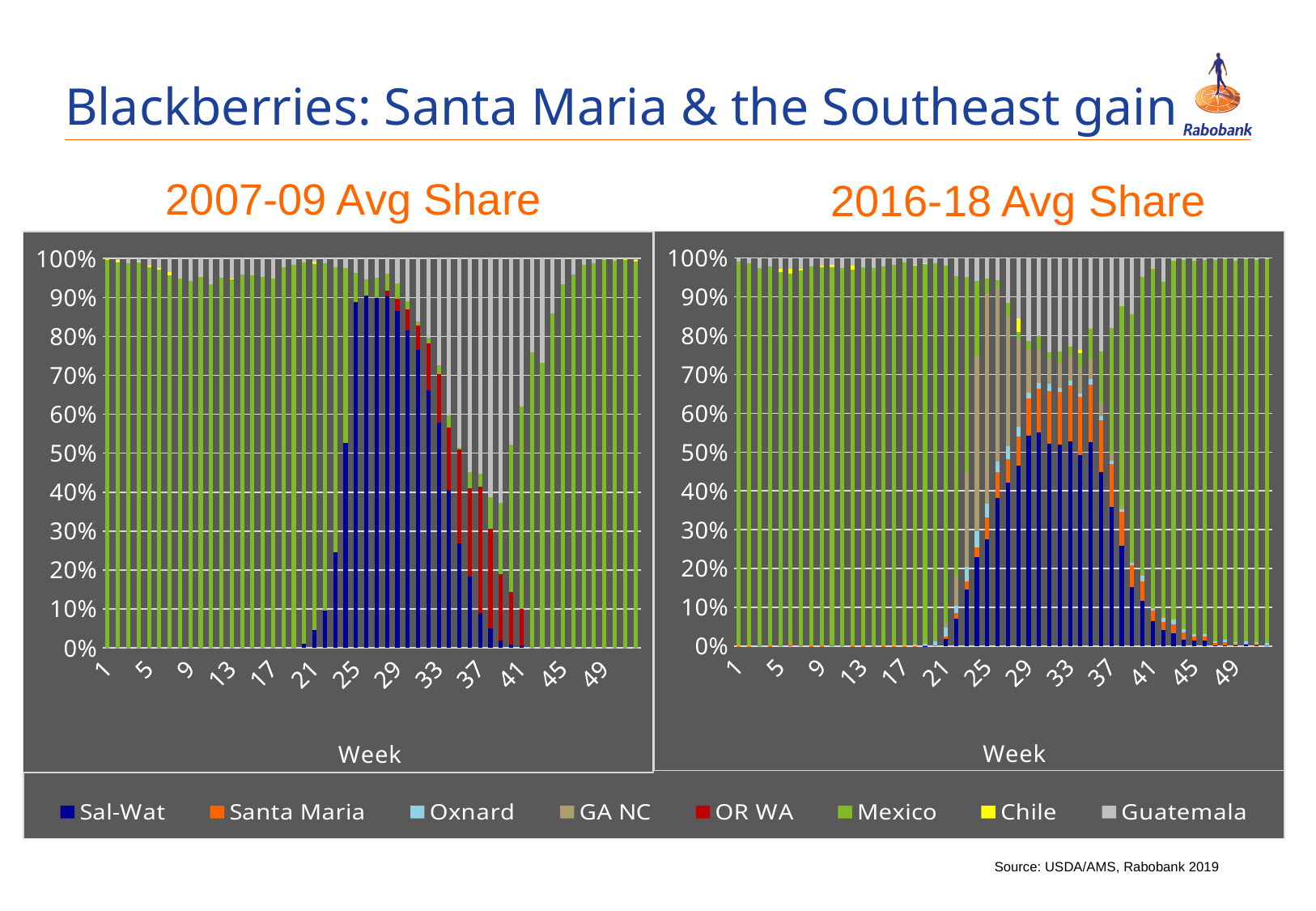
Which chart shows a higher peak share for Sal-Wat, the 2007-09 Avg Share chart or the 2016-18 Avg Share chart? 2007-09 Avg Share In the 2007-09 Avg Share chart, is the Sal-Wat share at week 27 greater or less than 80%? greater In the 2016-18 Avg Share chart, is the Sal-Wat share at week 29 greater or less than 40%? greater What kind of chart is the 2007-09 Avg Share chart? Stacked bar chart How many series does the legend list for the charts? 8 In the 2016-18 Avg Share chart, is the Mexico share at week 5 greater or less than 90%? greater What is the x-axis label on the 2016-18 Avg Share chart? Week Which colour represents Santa Maria in the legend? Orange In the 2016-18 Avg Share chart, does the Mexico share rise or fall from week 37 to week 49? rise In the 2007-09 Avg Share chart, does the Sal-Wat share rise or fall from week 29 to week 41? fall